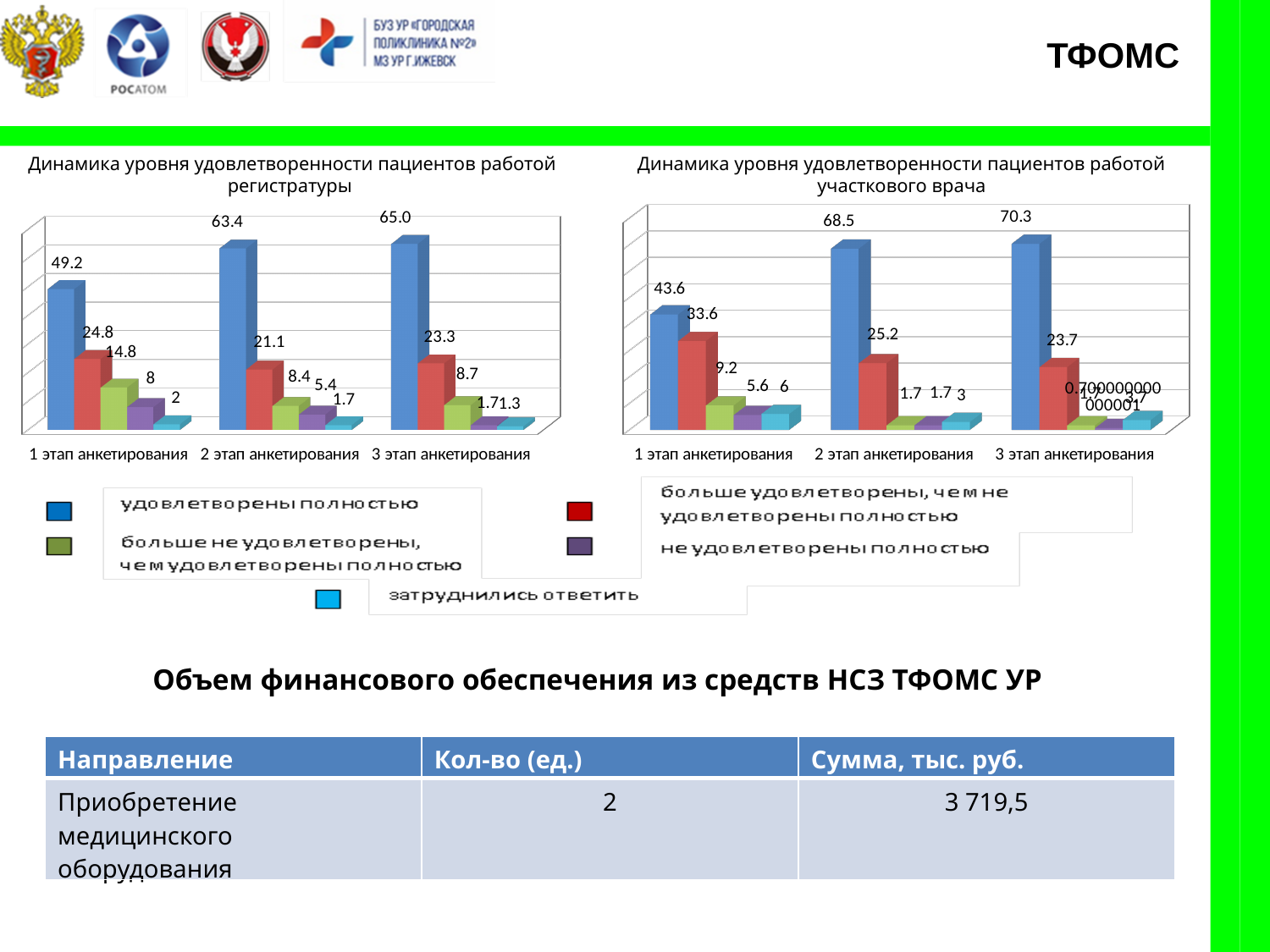
How does the value for 'удовлетворены полностью' change from stage 1 to stage 3 in the chart 'Динамика уровня удовлетворенности пациентов работой регистратуры'? It rises What type of chart is 'Динамика уровня удовлетворенности пациентов работой участкового врача'? Bar chart In the chart 'Динамика уровня удовлетворенности пациентов работой регистратуры', what is the value for 'удовлетворены полностью' at '3 этап анкетирования'? 65.0 In the chart 'Динамика уровня удовлетворенности пациентов работой регистратуры', what is the value for 'удовлетворены полностью' at '1 этап анкетирования'? 49.2 In the chart 'Динамика уровня удовлетворенности пациентов работой участкового врача', what is the difference between the 'удовлетворены полностью' values at '3 этап анкетирования' and '1 этап анкетирования'? 26.7 In the chart 'Динамика уровня удовлетворенности пациентов работой участкового врача', what is the value for 'удовлетворены полностью' at '2 этап анкетирования'? 68.5 In the chart 'Динамика уровня удовлетворенности пациентов работой участкового врача', what is the value for 'больше удовлетворены, чем не удовлетворены полностью' at '1 этап анкетирования'? 33.6 In the chart 'Динамика уровня удовлетворенности пациентов работой участкового врача', at which stage is the value for 'удовлетворены полностью' the highest? 3 этап анкетирования How many series does the shared legend list for the two charts? 5 In the chart 'Динамика уровня удовлетворенности пациентов работой регистратуры', which is larger at '1 этап анкетирования': 'больше удовлетворены, чем не удовлетворены полностью' or 'больше не удовлетворены, чем удовлетворены полностью'? больше удовлетворены, чем не удовлетворены полностью In the chart 'Динамика уровня удовлетворенности пациентов работой регистратуры', what is the difference between the 'удовлетворены полностью' values at '2 этап анкетирования' and '1 этап анкетирования'? 14.2 In the chart 'Динамика уровня удовлетворенности пациентов работой регистратуры', at which stage is the value for 'удовлетворены полностью' the lowest? 1 этап анкетирования